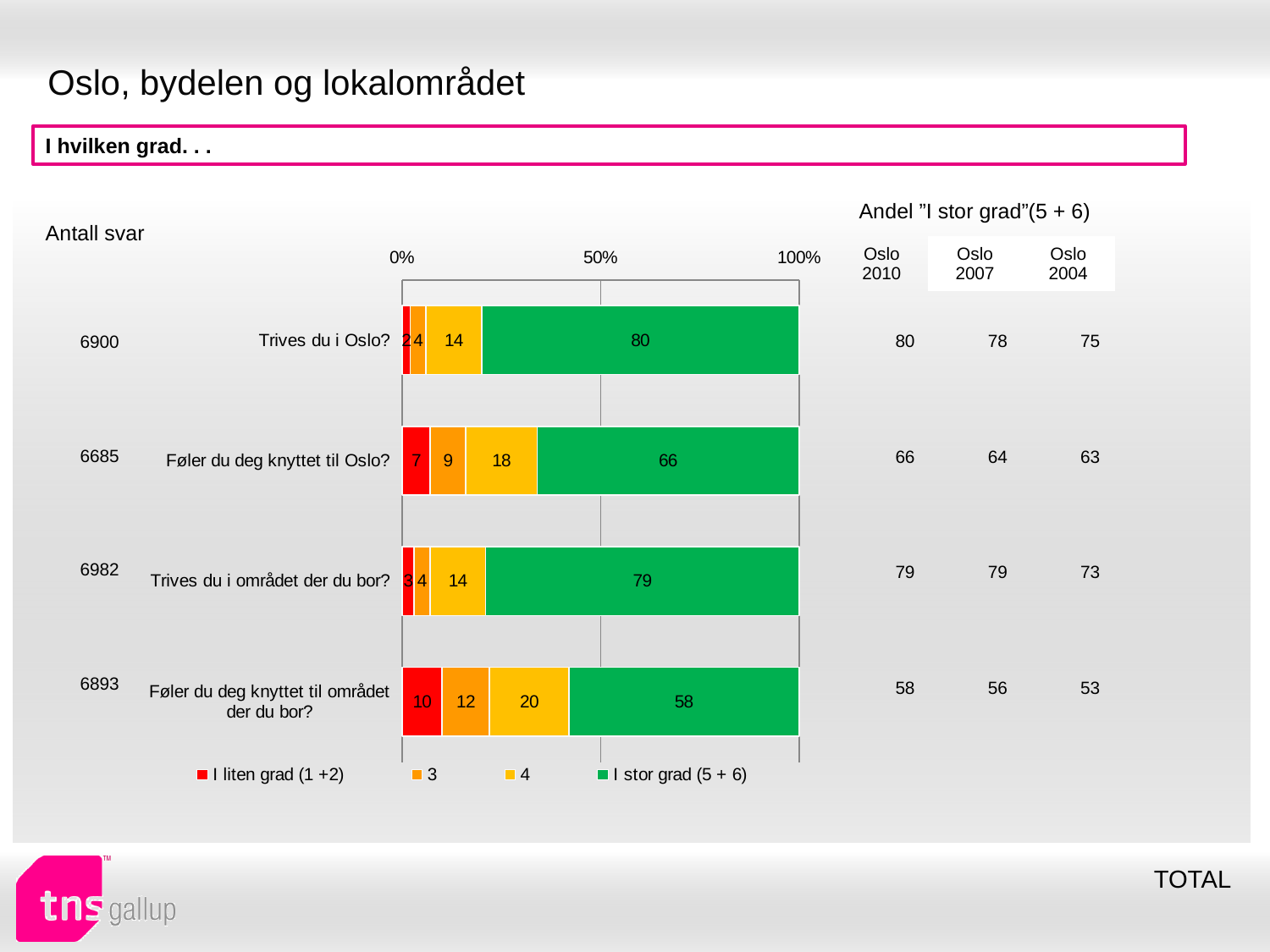
What is the value of series "4" for "Føler du deg knyttet til Oslo?"? 18 Which category has the highest value for "I stor grad (5 + 6)"? Trives du i Oslo? What is the value of "I stor grad (5 + 6)" for "Trives du i Oslo?"? 80 How many series does the legend list? 4 How many categories (questions) are shown in the bar chart? 4 Which is larger: the "I liten grad (1 +2)" value for "Føler du deg knyttet til Oslo?" or for "Føler du deg knyttet til området der du bor?"? Føler du deg knyttet til området der du bor? What kind of chart is shown on the slide? Stacked bar chart What is the value of "I liten grad (1 +2)" for "Føler du deg knyttet til området der du bor?"? 10 What is the value of series "3" for "Trives du i området der du bor?"? 4 Which category has the lowest value for "I stor grad (5 + 6)"? Føler du deg knyttet til området der du bor? Is the "I stor grad (5 + 6)" value for "Føler du deg knyttet til området der du bor?" greater or less than 50%? greater What is the difference between the "I stor grad (5 + 6)" values for "Føler du deg knyttet til Oslo?" and "Føler du deg knyttet til området der du bor?"? 8